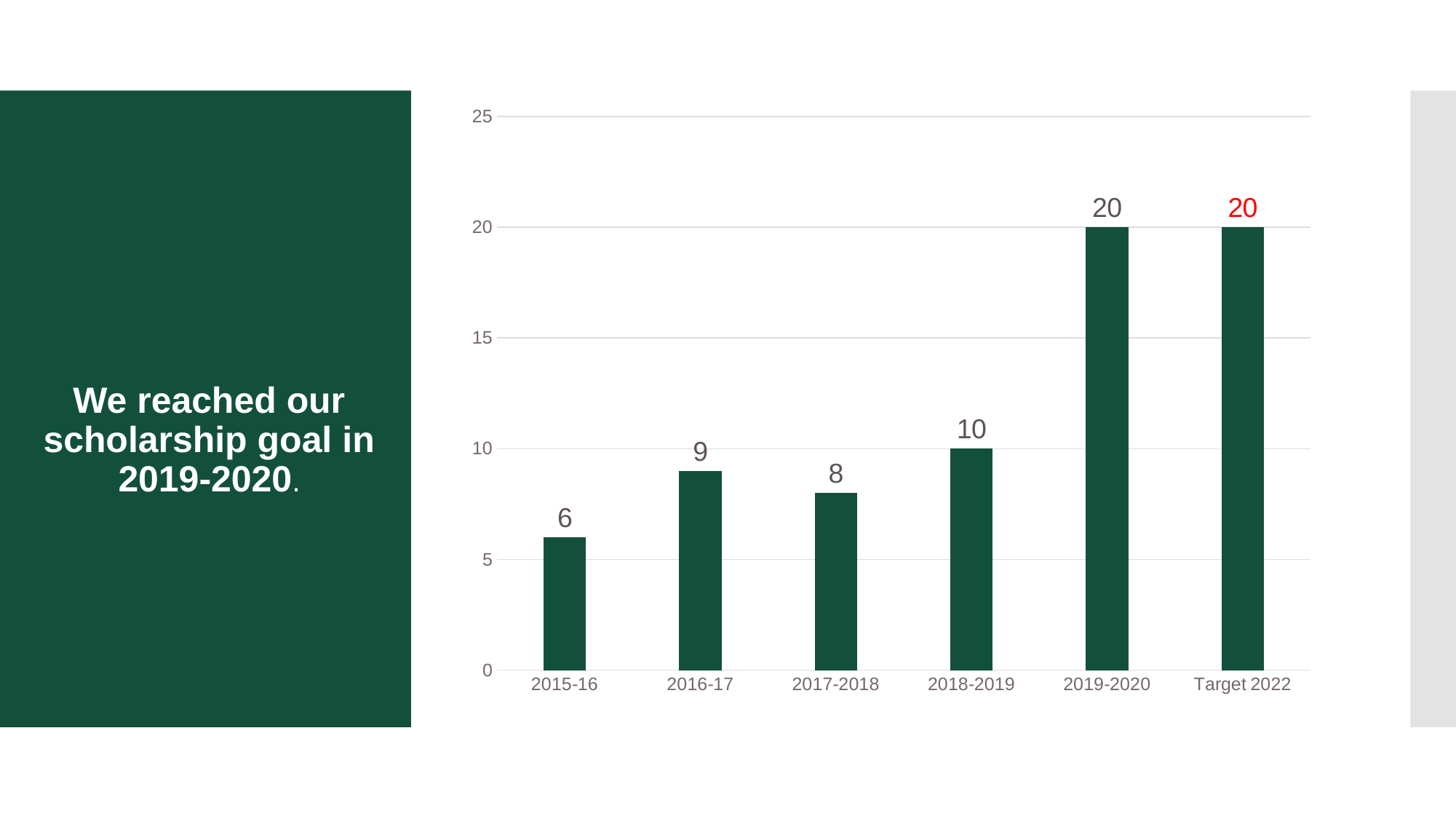
What is the value for 2017-2018? 8 What kind of chart is shown on the slide? bar chart Which category has the lowest value? 2015-16 What is the difference between the values for 2016-17 and 2017-2018? 1 What is the value for Target 2022? 20 Which data label is shown in red? Target 2022 Which is larger, the value for 2016-17 or the value for 2017-2018? 2016-17 How many categories are shown on the x axis? 6 What is the difference between the values for 2019-2020 and 2018-2019? 10 What is the value for 2015-16? 6 What is the value for 2019-2020? 20 Is the value for 2018-2019 greater or less than 15? less